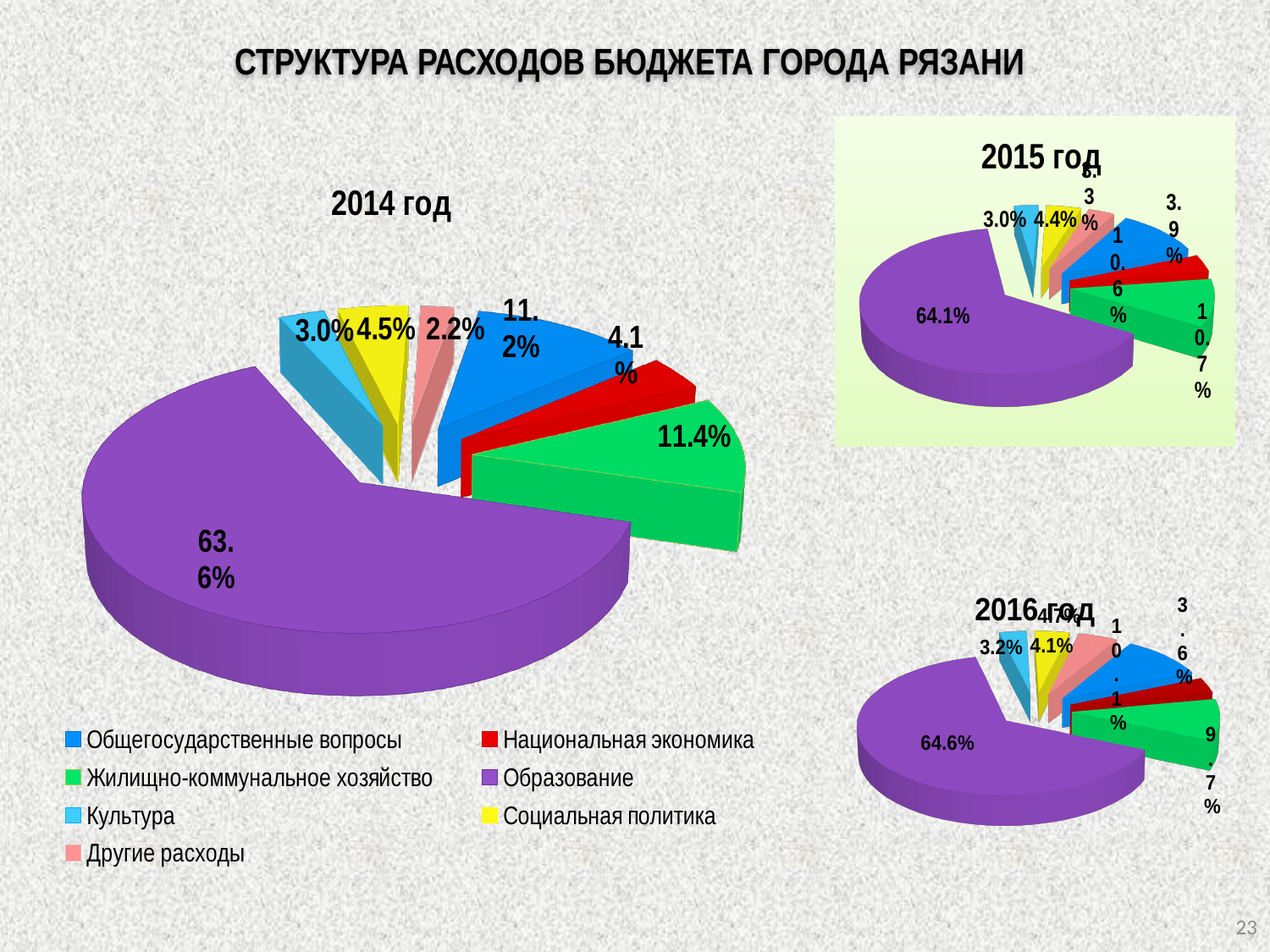
How many categories does the legend list? 7 In the 2014 год chart, what is the difference between the shares of Социальная политика and Культура? 1.5% In the 2014 год chart, what share does Жилищно-коммунальное хозяйство have? 11.4% In the 2014 год chart, what share does Национальная экономика have? 4.1% In the 2014 год chart, what share does Образование have? 63.6% What kind of chart is used for the 2014 год chart? pie chart In the 2014 год chart, which category has the largest share? Образование In the 2015 год chart, what share does Образование have? 64.1% In the 2016 год chart, which is larger: the share of Жилищно-коммунальное хозяйство or the share of Общегосударственные вопросы? Общегосударственные вопросы In the 2014 год chart, which category has the smallest share? Другие расходы In the 2015 год chart, what share does Социальная политика have? 4.4% In the 2016 год chart, what share does Образование have? 64.6%